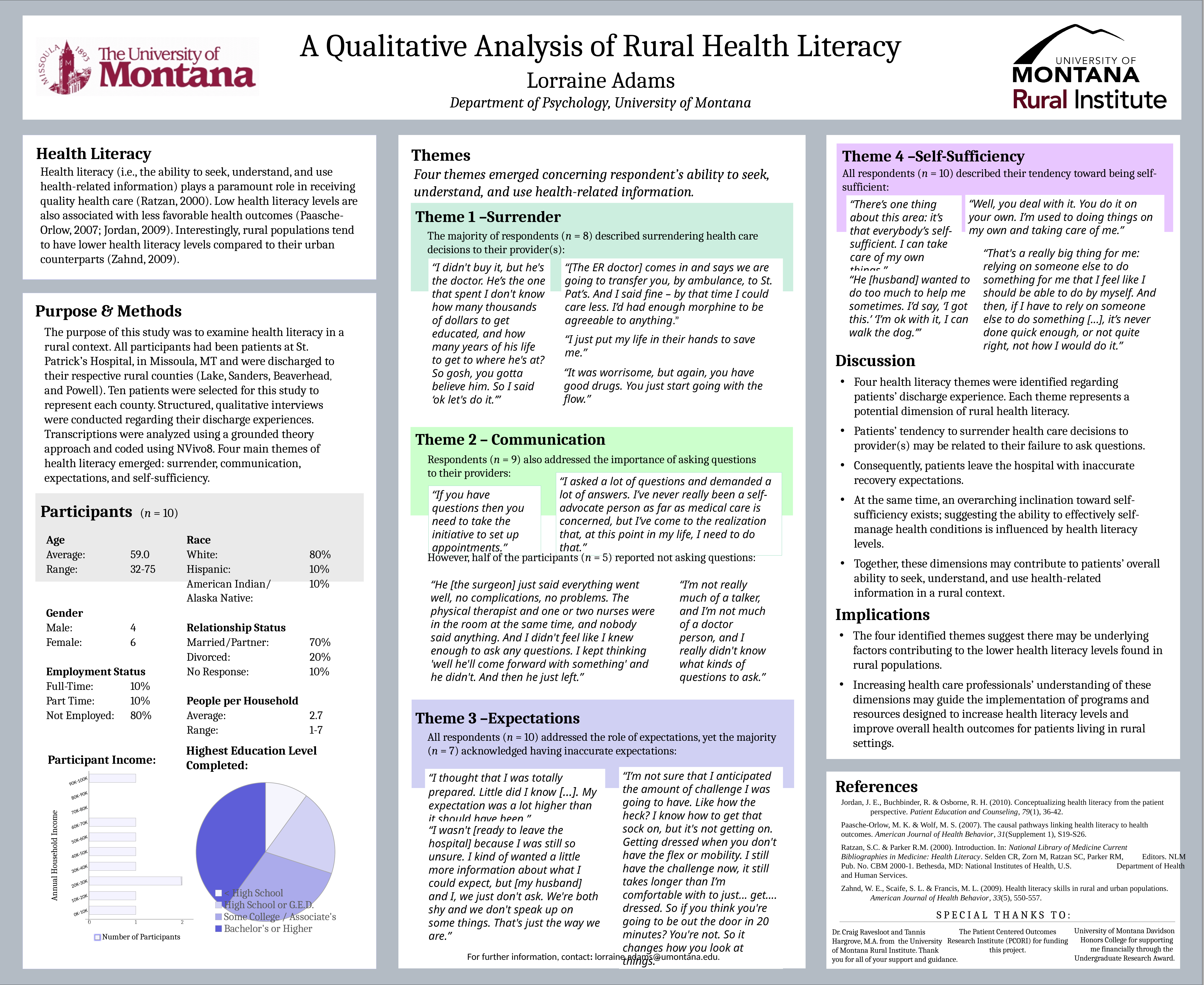
In the Highest Education Level Completed pie chart, how many slices are there? 4 In the Participant Income chart, what is the title of the vertical axis? Annual Household Income In the Participant Income chart, which has more participants: 20K-30K or 40K-50K? 20K-30K What kind of chart is the Participant Income chart? bar chart In the Participant Income chart, how many participants are in the 20K-30K income category? 2 In the Participant Income chart, how many participants are in the 0K-10K income category? 1 In the Participant Income chart, which income category has the most participants? 20K-30K What kind of chart is the Highest Education Level Completed chart? pie chart In the Participant Income chart, how many series does the legend list? 1 In the Highest Education Level Completed pie chart, which education level has the largest slice? Bachelor's or Higher In the Participant Income chart, how many income categories are shown on the vertical axis? 10 In the Participant Income chart, what is the legend entry for the series? Number of Participants